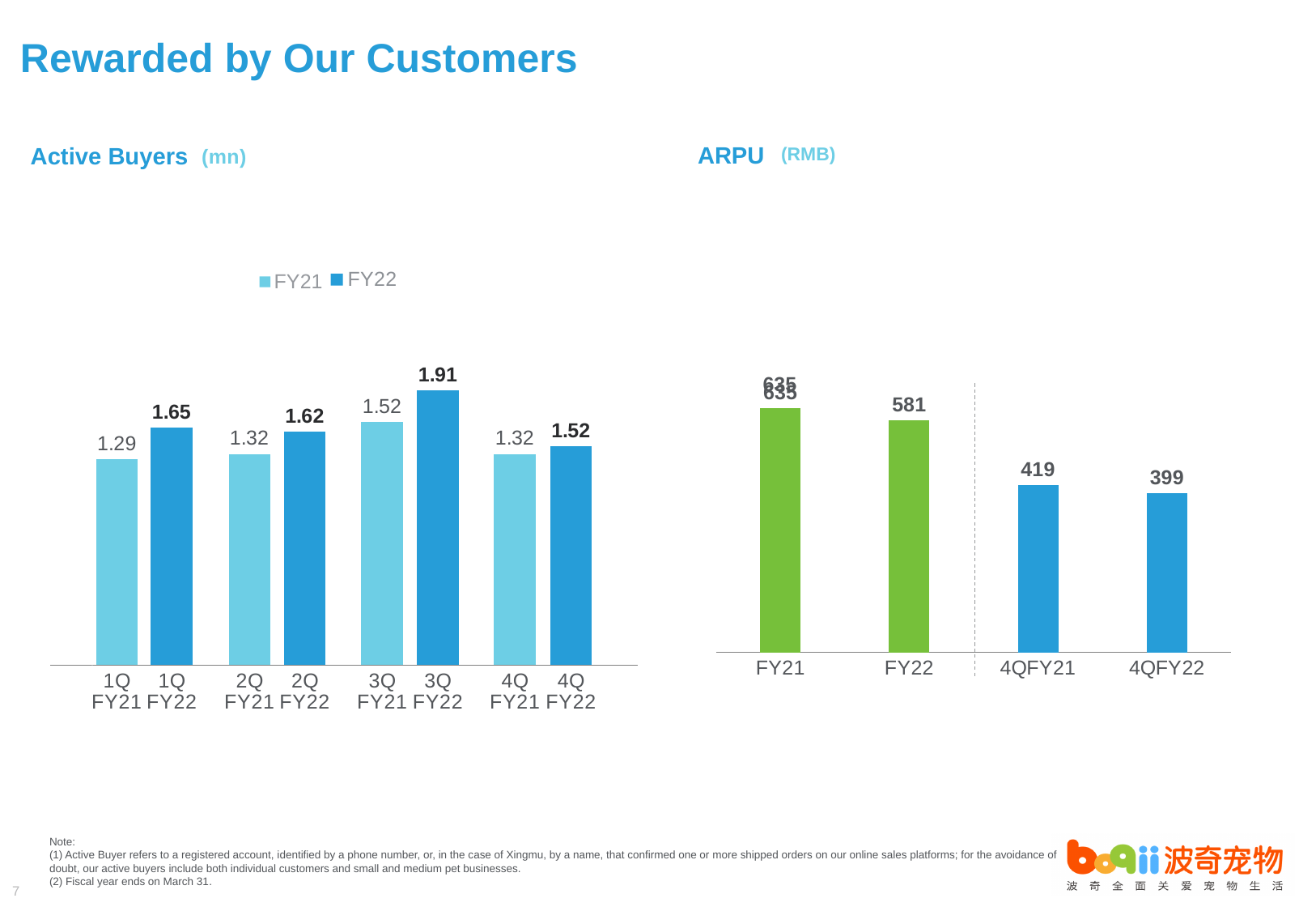
In the Active Buyers chart, what is the value for 1Q FY21? 1.29 What type of chart is the ARPU chart? bar chart How many series does the legend of the Active Buyers chart list? 2 In the ARPU chart, what is the difference between 4QFY21 and 4QFY22? 20 In the Active Buyers chart, what is the difference between 1Q FY22 and 1Q FY21? 0.36 In the Active Buyers chart, which is larger: 2Q FY22 or 4Q FY22? 2Q FY22 In the Active Buyers chart, which quarter has the lowest value? 1Q FY21 What unit is shown next to the ARPU chart title? RMB How many bars are plotted in the Active Buyers chart? 8 In the ARPU chart, what is the value for FY22? 581 In the Active Buyers chart, what is the value for 3Q FY22? 1.91 In the Active Buyers chart, which quarter has the highest value? 3Q FY22